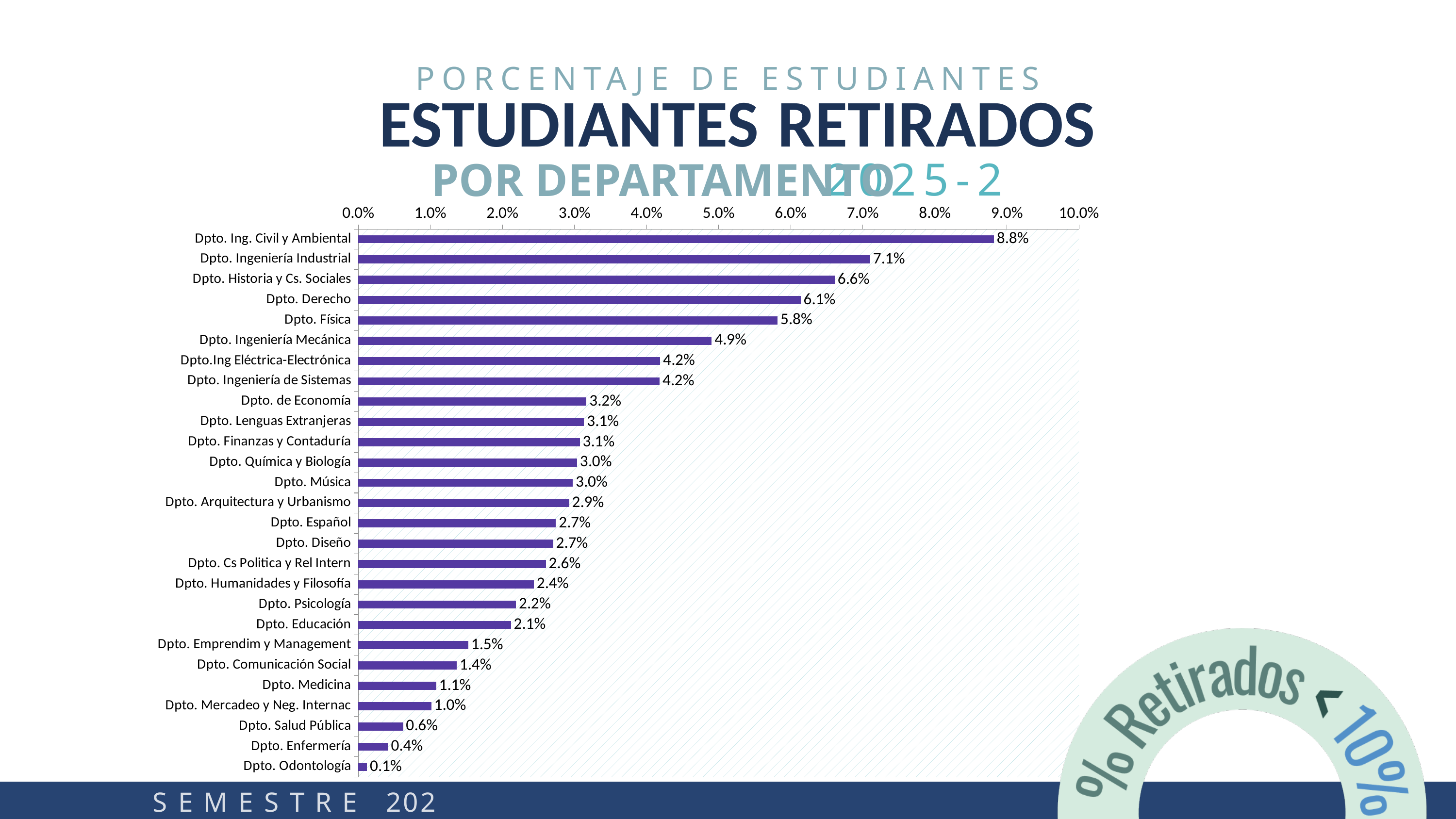
How many departments are shown in the chart? 27 What is the value for Dpto. Psicología? 2.2% Is the value for Dpto. Ingeniería Industrial greater or less than 5.0%? greater What is the value for Dpto. Medicina? 1.1% Which department has the highest value? Dpto. Ing. Civil y Ambiental What is the difference between Dpto. Física and Dpto. Ingeniería Mecánica? 0.9% What kind of chart is shown on the slide? bar chart What is the value for Dpto. Derecho? 6.1% Which department has the lowest value? Dpto. Odontología Which is larger, the value for Dpto. Historia y Cs. Sociales or the value for Dpto. de Economía? Dpto. Historia y Cs. Sociales What is the difference between Dpto. Ing. Civil y Ambiental and Dpto. Ingeniería Industrial? 1.7% What is the maximum value shown on the horizontal axis? 10.0%